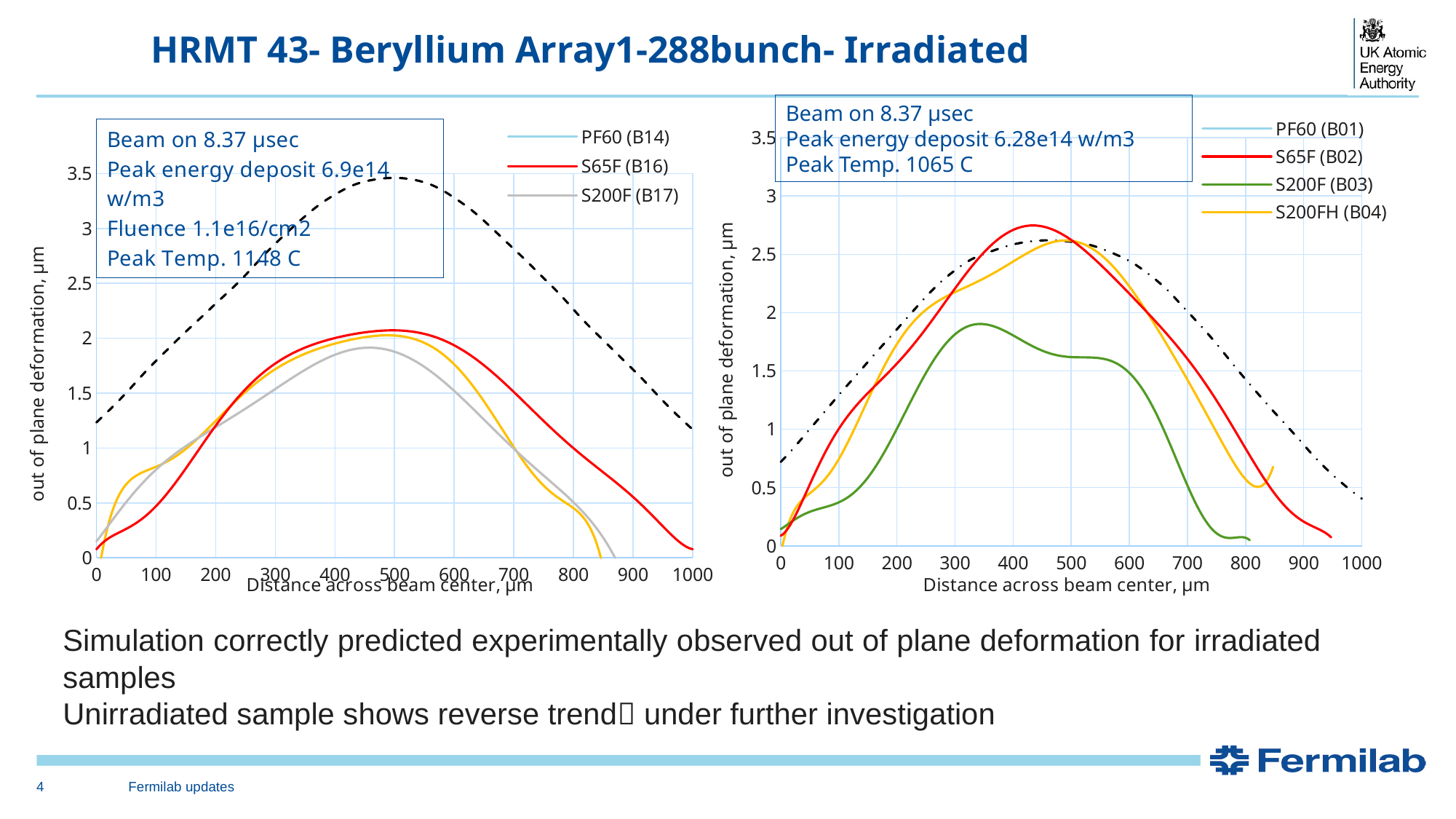
What is the y-axis title of the right chart? out of plane deformation, µm How many series does the legend of the right chart list? 4 In the left chart, does the S65F (B16) line rise or fall between 0 and 500 µm? rise In the right chart, is the peak value of the S200F (B03) line greater or less than 2? less In the right chart, which has the higher peak deformation, S65F (B02) or S200F (B03)? S65F (B02) How many series does the legend of the left chart list? 3 What is the x-axis title of the left chart? Distance across beam center, µm In the left chart, is the peak value of the S200F (B17) line greater or less than 2? less In the left chart, is the peak value of the black dashed line greater or less than 3? greater In the right chart, which series reaches the lowest peak deformation? S200F (B03) What kind of chart is the left chart? line chart